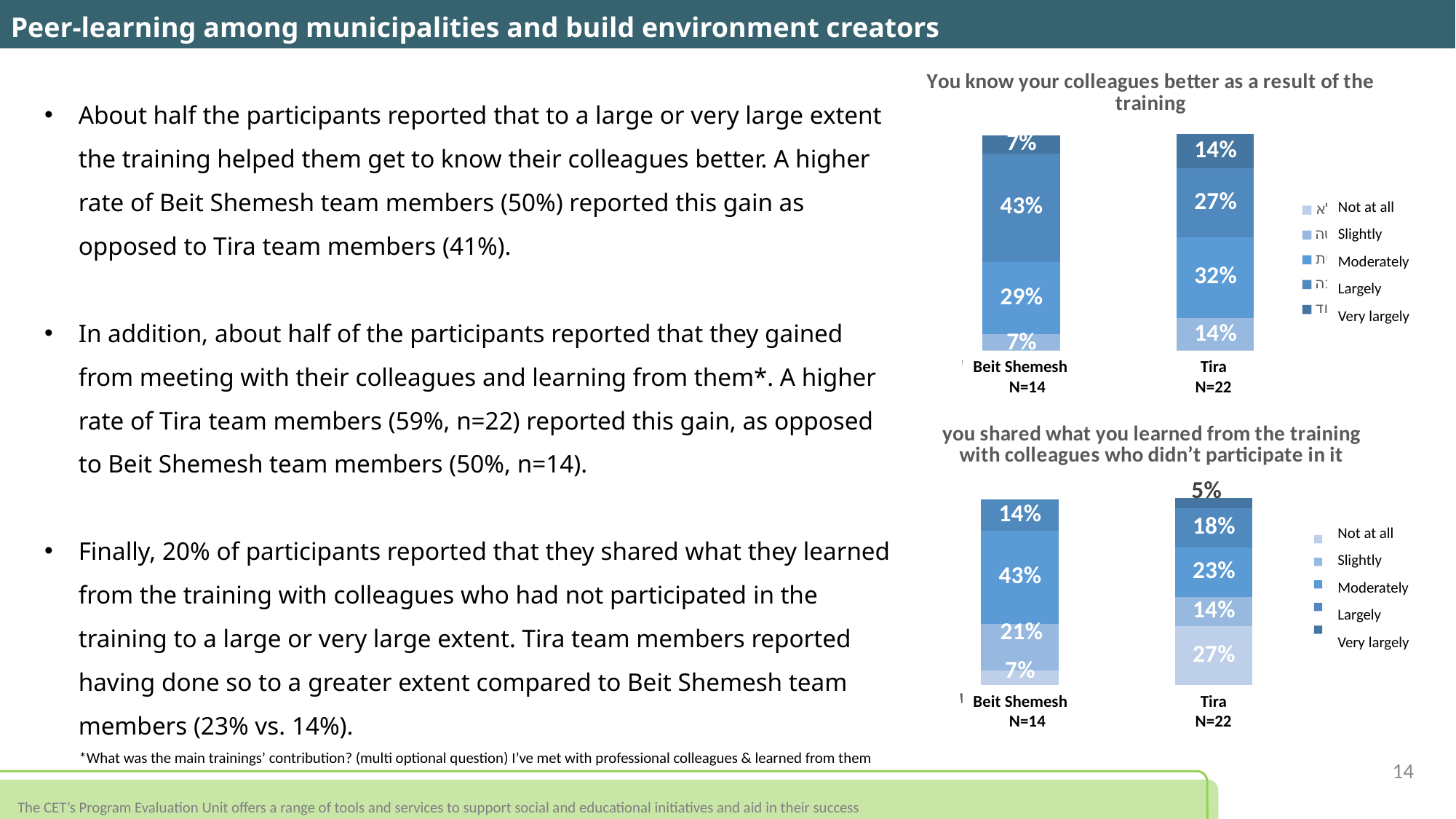
How many bars (municipalities) are shown in the top chart ('You know your colleagues better as a result of the training')? 2 In the top chart ('You know your colleagues better as a result of the training'), what is the difference between the largest segment of Beit Shemesh (43%) and the largest segment of Tira (32%)? 11 percentage points In the top chart ('You know your colleagues better as a result of the training'), what value is shown on the topmost segment of the Tira bar? 14% In the top chart ('You know your colleagues better as a result of the training'), what is the value of the largest segment in the Tira bar? 32% In the top chart ('You know your colleagues better as a result of the training'), what is the value of the largest segment in the Beit Shemesh bar? 43% What kind of chart is used in the top chart titled 'You know your colleagues better as a result of the training'? Stacked bar chart How many entries does the legend of the bottom chart ('you shared what you learned from the training with colleagues who didn't participate in it') list? 5 In the top chart ('You know your colleagues better as a result of the training'), what value is shown on the bottom segment of the Beit Shemesh bar? 7% In the bottom chart ('you shared what you learned from the training...'), what is the value of the largest segment in the Beit Shemesh bar? 43% In the bottom chart ('you shared what you learned from the training...'), what is the smallest labeled segment value in the Tira bar? 5% In the top chart ('You know your colleagues better as a result of the training'), which bar has the larger single largest segment, Beit Shemesh (43%) or Tira (32%)? Beit Shemesh In the bottom chart ('you shared what you learned from the training...'), what value is shown on the bottom segment of the Tira bar? 27%